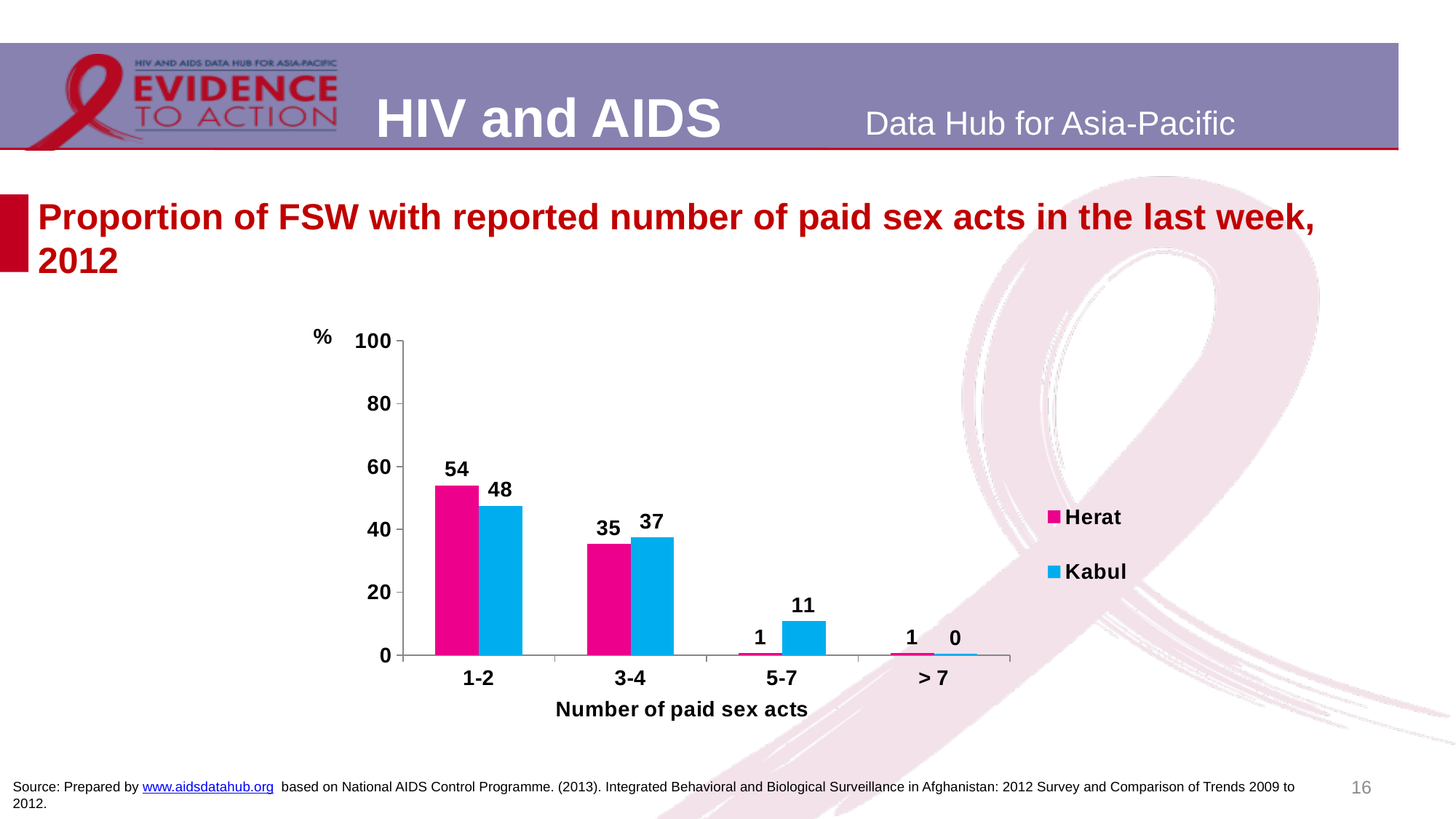
Which category has the highest value for Herat? 1-2 In the 5-7 category, which series has the larger value, Herat or Kabul? Kabul What is the value for Herat in the 1-2 category? 54 Is the value for Herat in the 3-4 category greater or less than 40? less How many series does the legend list? 2 What is the value for Kabul in the > 7 category? 0 How many categories are shown on the x axis? 4 Which category has the lowest value for Kabul? > 7 What kind of chart is shown on the slide? bar chart What is the value for Kabul in the 5-7 category? 11 What is the value for Kabul in the 3-4 category? 37 What is the difference between the Herat and Kabul values in the 1-2 category? 6